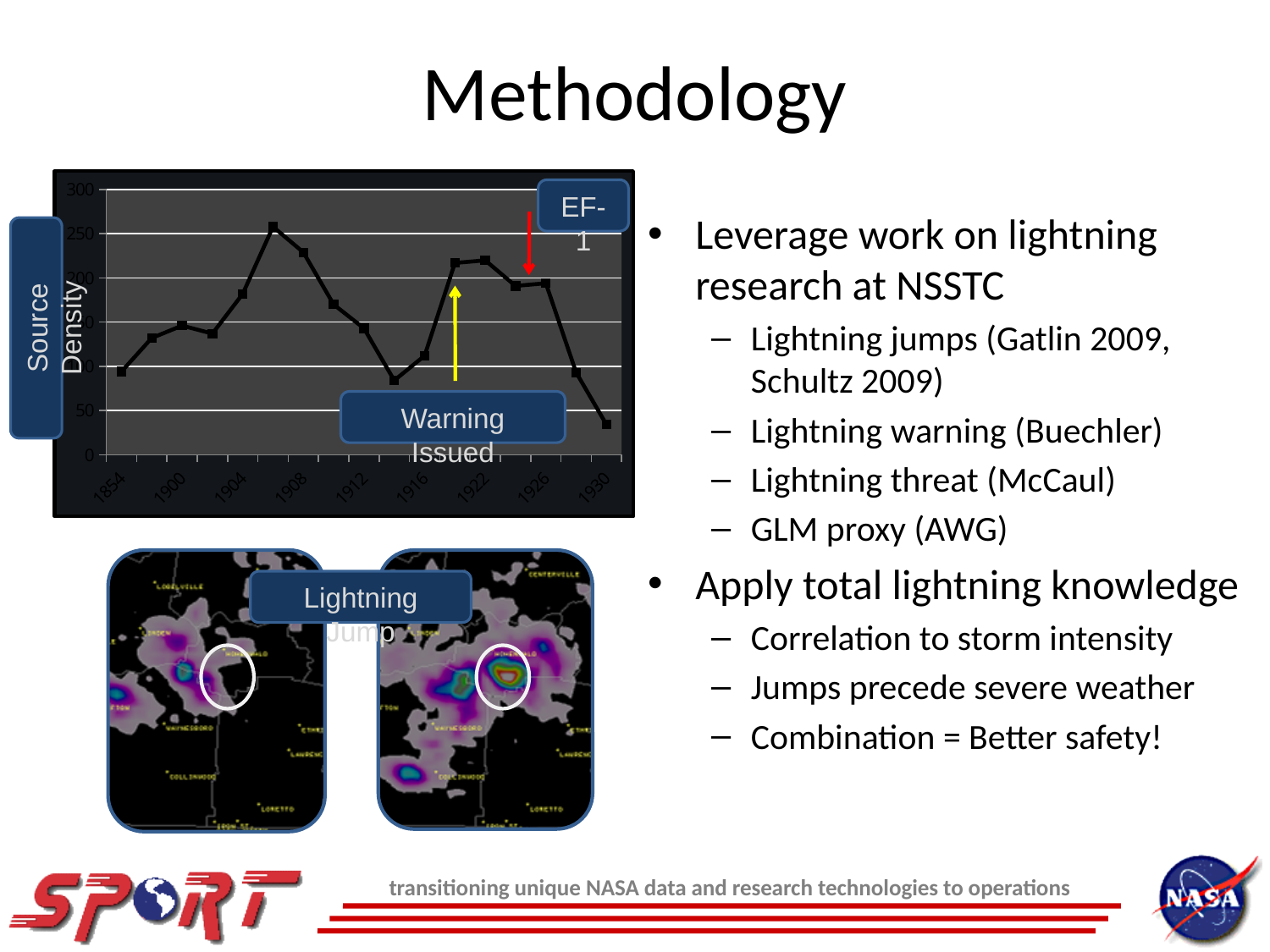
Do the values rise or fall between 1926 and 1930? fall Is the value at 1926 greater or less than 150? greater Is the value at 1916 greater or less than 150? less Which is larger, the value at 1908 or the value at 1916? 1908 What is the label on the y axis of the chart? Source Density What kind of chart is shown on the slide? line chart How many time labels are shown along the x axis of the chart? 9 Is the value at 1930 greater or less than 50? less What is the highest tick value shown on the y axis of the chart? 300 Which is larger, the value at 1922 or the value at 1930? 1922